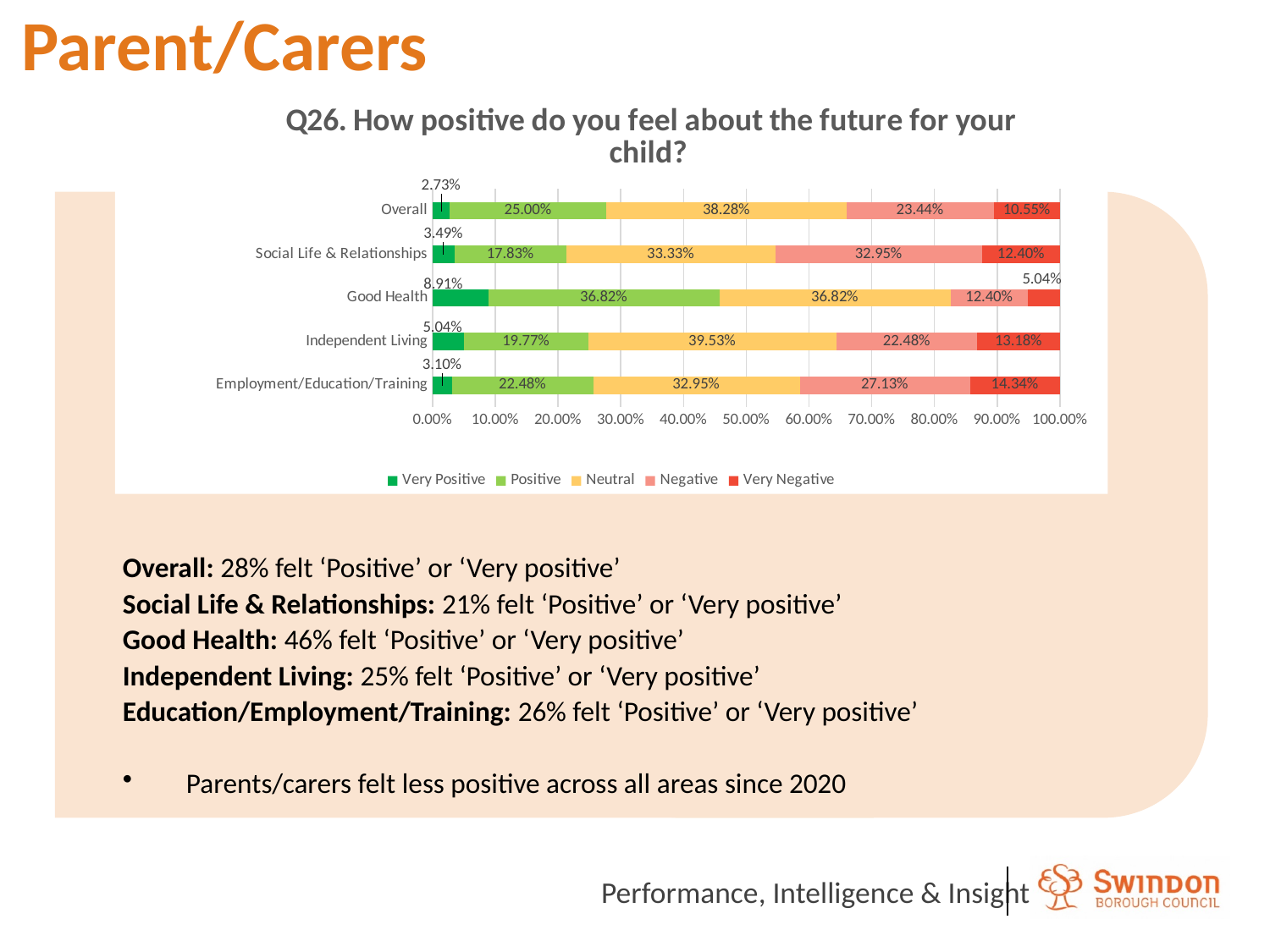
How many series does the legend list? 5 What is the Very Positive value for Good Health? 8.91% What is the Negative value for Social Life & Relationships? 32.95% What percentage of parents/carers felt Neutral about the future for their child Overall? 38.28% What is the difference between the Neutral value for Overall and the Neutral value for Social Life & Relationships? 4.95% Which category has the highest Very Positive percentage? Good Health Which is larger: the Negative value for Independent Living or the Negative value for Employment/Education/Training? Employment/Education/Training What is the Very Negative value for Employment/Education/Training? 14.34% What type of chart is shown on the slide? Stacked bar chart Which category has the lowest Positive percentage? Social Life & Relationships Which category has the lowest Very Negative percentage? Good Health How many categories are shown on the chart? 5